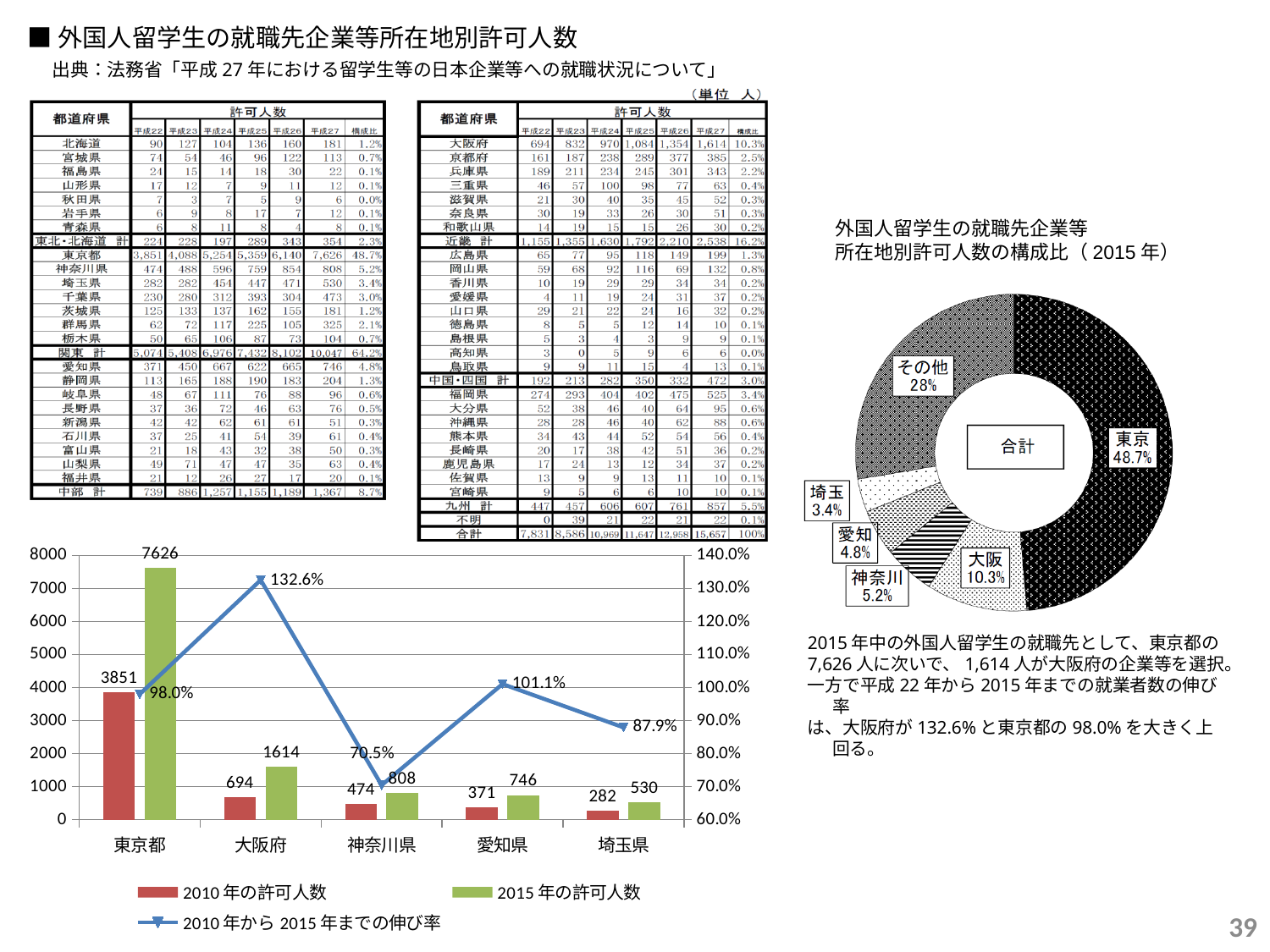
How many series does the legend of the bar chart at the bottom left list? 3 In the donut chart on the right, what share does 東京 have? 48.7% In the bar chart at the bottom left, what is the 2015年の許可人数 value for 東京都? 7626 In the bar chart at the bottom left, which prefecture has the highest 2015年の許可人数? 東京都 In the bar chart at the bottom left, which prefecture has the lowest 2010年から2015年までの伸び率? 神奈川県 In the bar chart at the bottom left, what is the 2010年から2015年までの伸び率 for 大阪府? 132.6% In the donut chart on the right, what share does 大阪 have? 10.3% In the donut chart on the right, which labelled slice is the smallest? 埼玉 In the bar chart at the bottom left, what is the 2010年の許可人数 value for 大阪府? 694 In the bar chart at the bottom left, what is the difference between the 2015 and 2010 許可人数 for 神奈川県? 334 How many prefectures are shown on the x axis of the bar chart at the bottom left? 5 In the bar chart at the bottom left, which is larger: the 2015年の許可人数 for 愛知県 or for 埼玉県? 愛知県